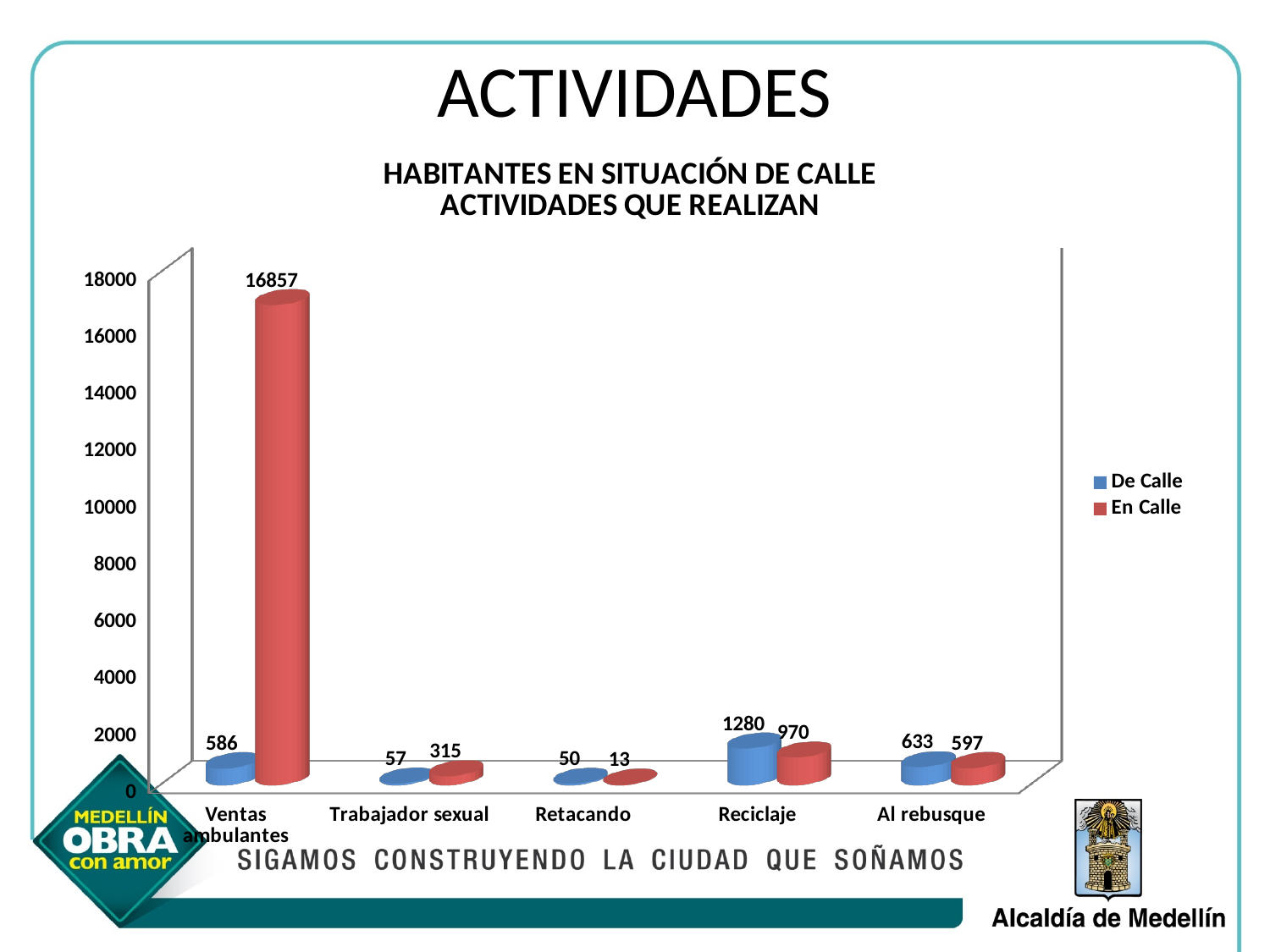
What is the value for En Calle in the Retacando category? 13 What is the difference between the De Calle and En Calle values for Reciclaje? 310 What is the difference between the En Calle and De Calle values for Ventas ambulantes? 16271 Which category has the lowest De Calle value? Retacando Which is larger for Al rebusque, the De Calle value or the En Calle value? De Calle How many categories are shown on the x axis? 5 What kind of chart is shown on the slide? Bar chart What is the value for De Calle in the Trabajador sexual category? 57 How many series does the legend list? 2 Which category has the highest En Calle value? Ventas ambulantes What is the value for De Calle in the Reciclaje category? 1280 What is the value for En Calle in the Ventas ambulantes category? 16857